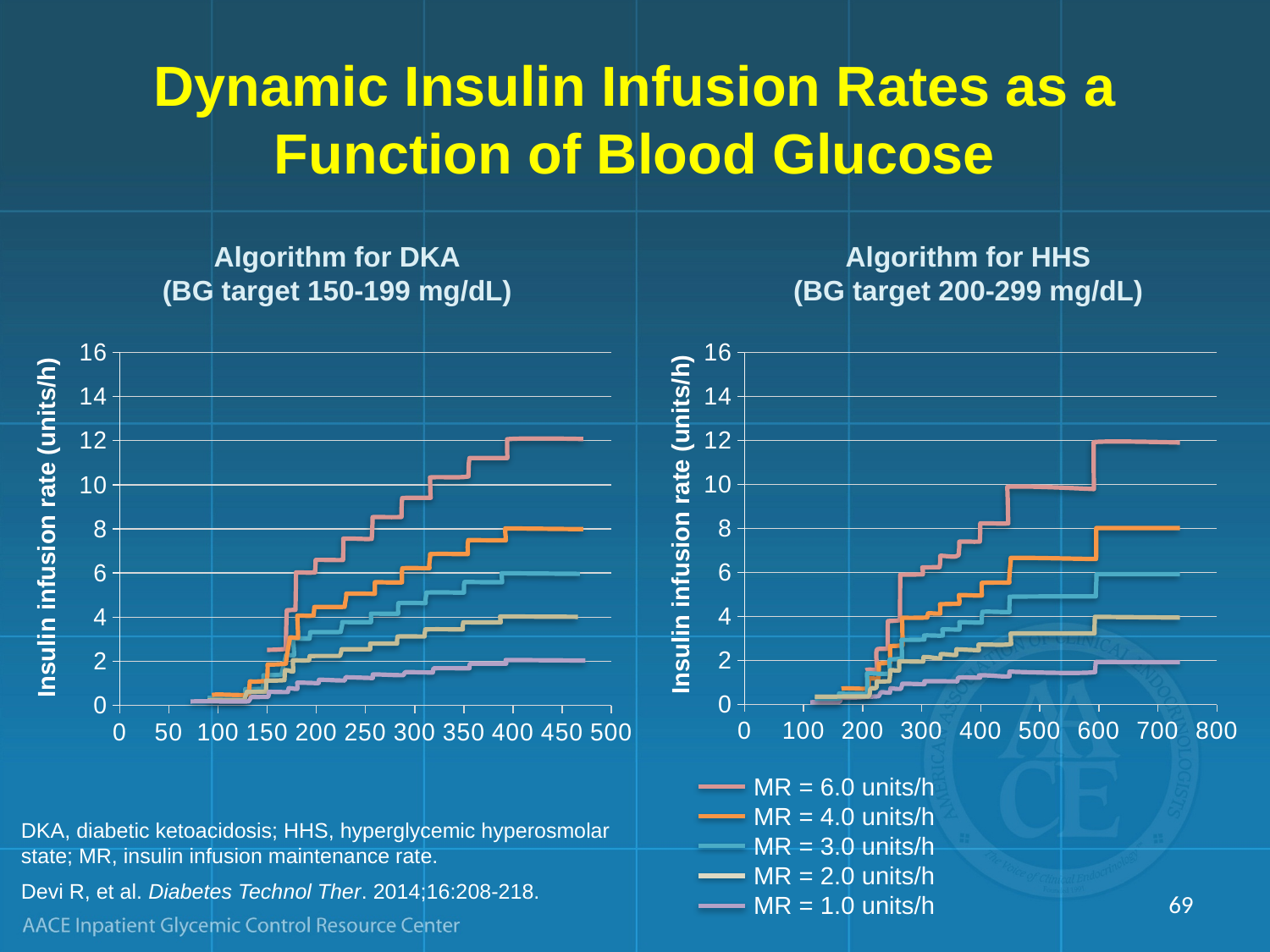
In the 'Algorithm for DKA' chart, do the insulin infusion rates rise or fall as blood glucose increases along the x axis? rise In the 'Algorithm for HHS' chart, do the insulin infusion rates rise or fall as blood glucose increases along the x axis? rise In the 'Algorithm for HHS' chart, is the value of the MR = 6.0 units/h line at a blood glucose of 500 greater or less than 8? greater What kind of chart is the 'Algorithm for DKA' chart? line chart In the 'Algorithm for DKA' chart, is the value of the MR = 4.0 units/h line at a blood glucose of 250 greater or less than 6? less In the 'Algorithm for DKA' chart, is the value of the MR = 6.0 units/h line at a blood glucose of 300 greater or less than 8? greater In the 'Algorithm for DKA' chart, which line is higher at a blood glucose of 300: MR = 6.0 units/h or MR = 1.0 units/h? MR = 6.0 units/h What is the y-axis label on the 'Algorithm for HHS' chart? Insulin infusion rate (units/h) In the 'Algorithm for HHS' chart, which series reaches the highest insulin infusion rate? MR = 6.0 units/h In the 'Algorithm for DKA' chart, which series has the lowest insulin infusion rate across the blood glucose range? MR = 1.0 units/h How many series does the legend list for the charts? 5